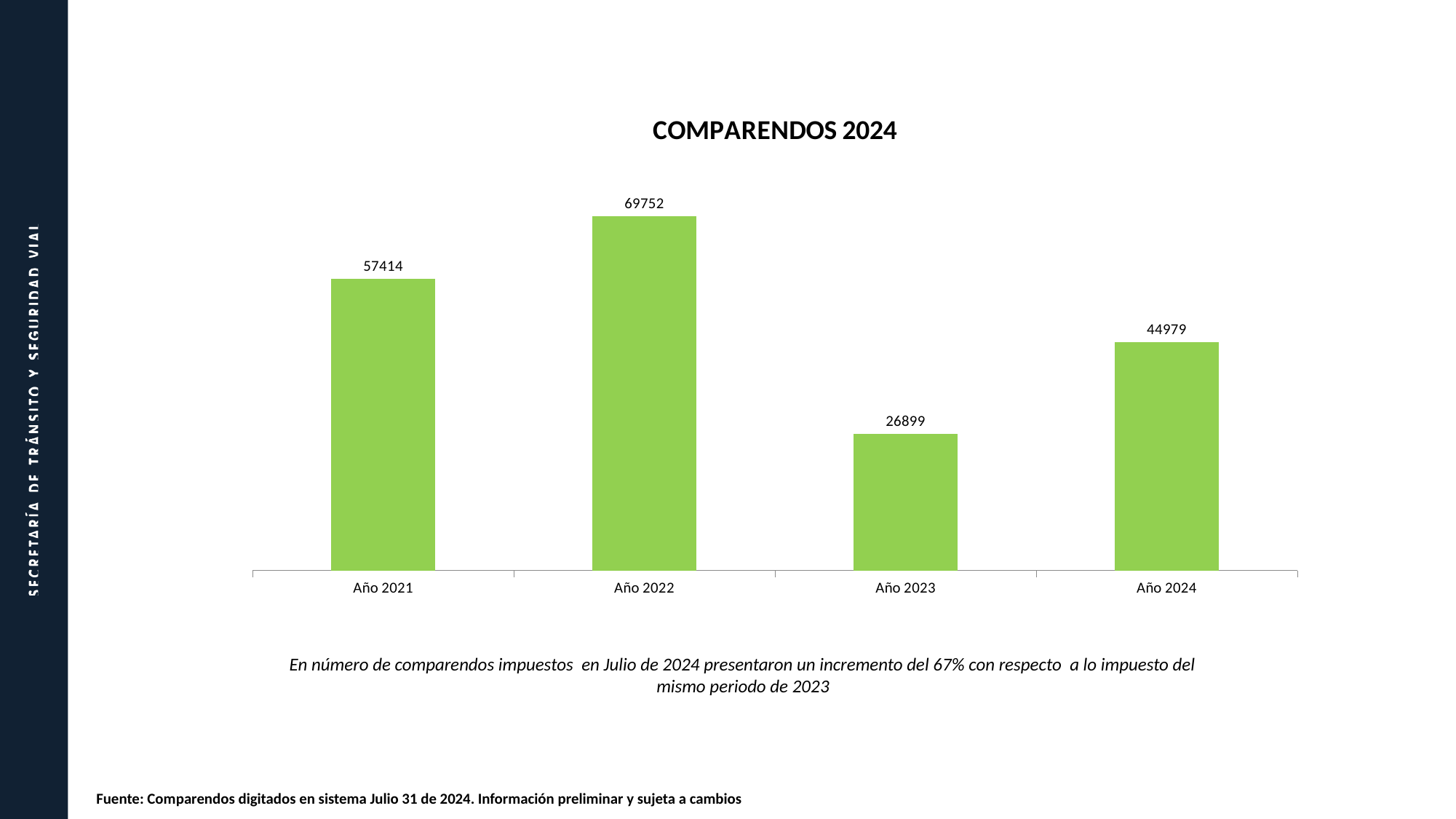
Which year has the lowest value? Año 2023 Which year has the highest value? Año 2022 What is the value for Año 2024? 44979 What is the difference between the values for Año 2022 and Año 2021? 12338 What kind of chart is shown? Bar chart How many years are shown on the chart? 4 What is the difference between the values for Año 2024 and Año 2023? 18080 What is the value for Año 2021? 57414 Which is larger, the value for Año 2021 or the value for Año 2024? Año 2021 What is the value for Año 2022? 69752 What is the value for Año 2023? 26899 What is the title of the chart? COMPARENDOS 2024